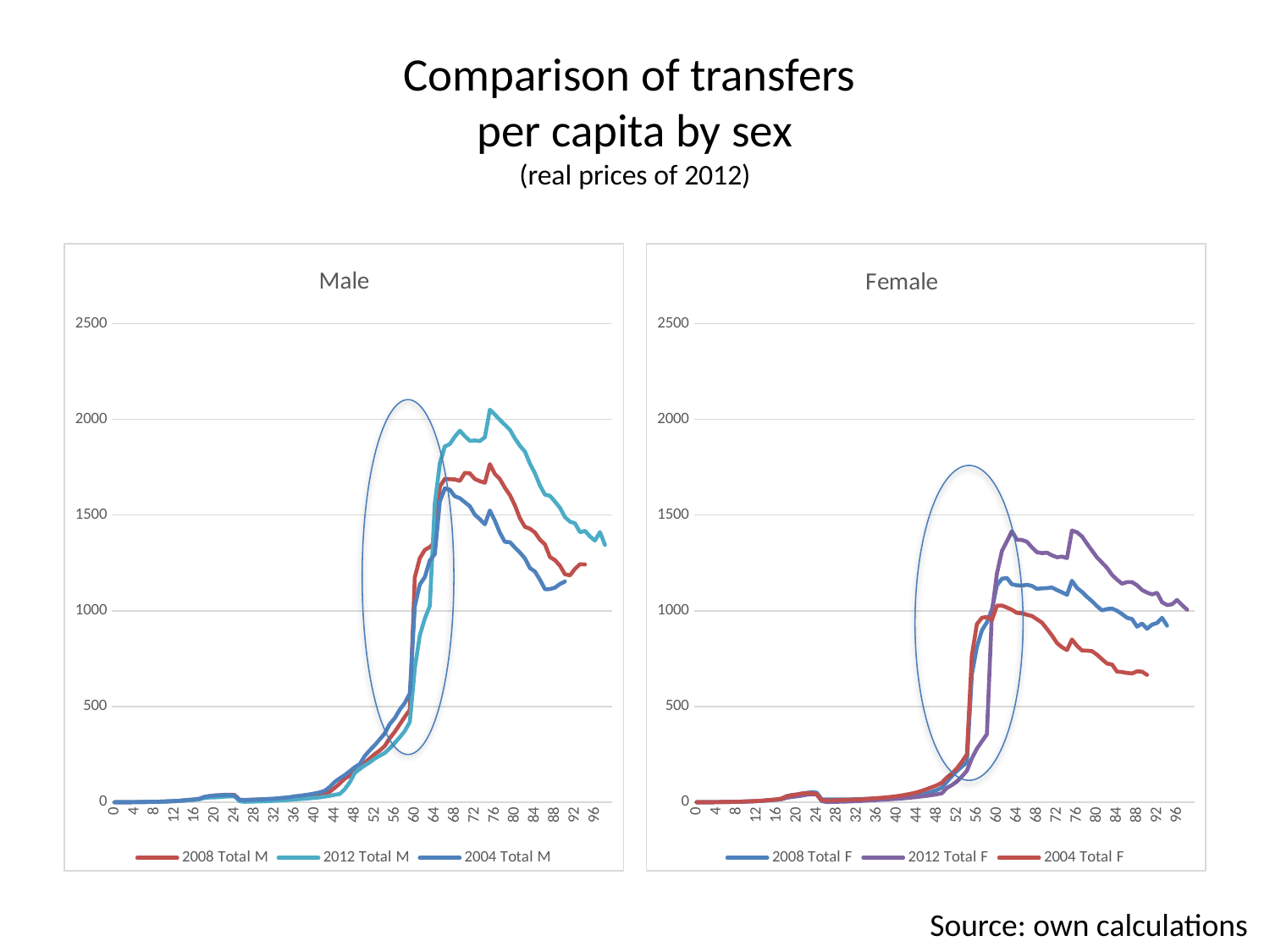
In the Male chart, do the values of 2012 Total M rise or fall between age 40 and age 64? rise What is the title of the right-hand chart? Female In the Female chart, is the peak value of 2012 Total F greater or less than 1500? less In the Female chart, is the value of 2004 Total F at age 88 greater or less than 500? greater What are the legend entries of the Male chart? 2008 Total M, 2012 Total M, 2004 Total M What kind of chart is the Male chart? line chart How many series does the legend of the Female chart list? 3 In the Male chart, is the peak value of 2012 Total M greater or less than 2000? greater In the Female chart, at age 80, which series is larger: 2008 Total F or 2004 Total F? 2008 Total F In the Male chart, which series reaches the highest value? 2012 Total M In the Female chart, which series reaches the highest value? 2012 Total F